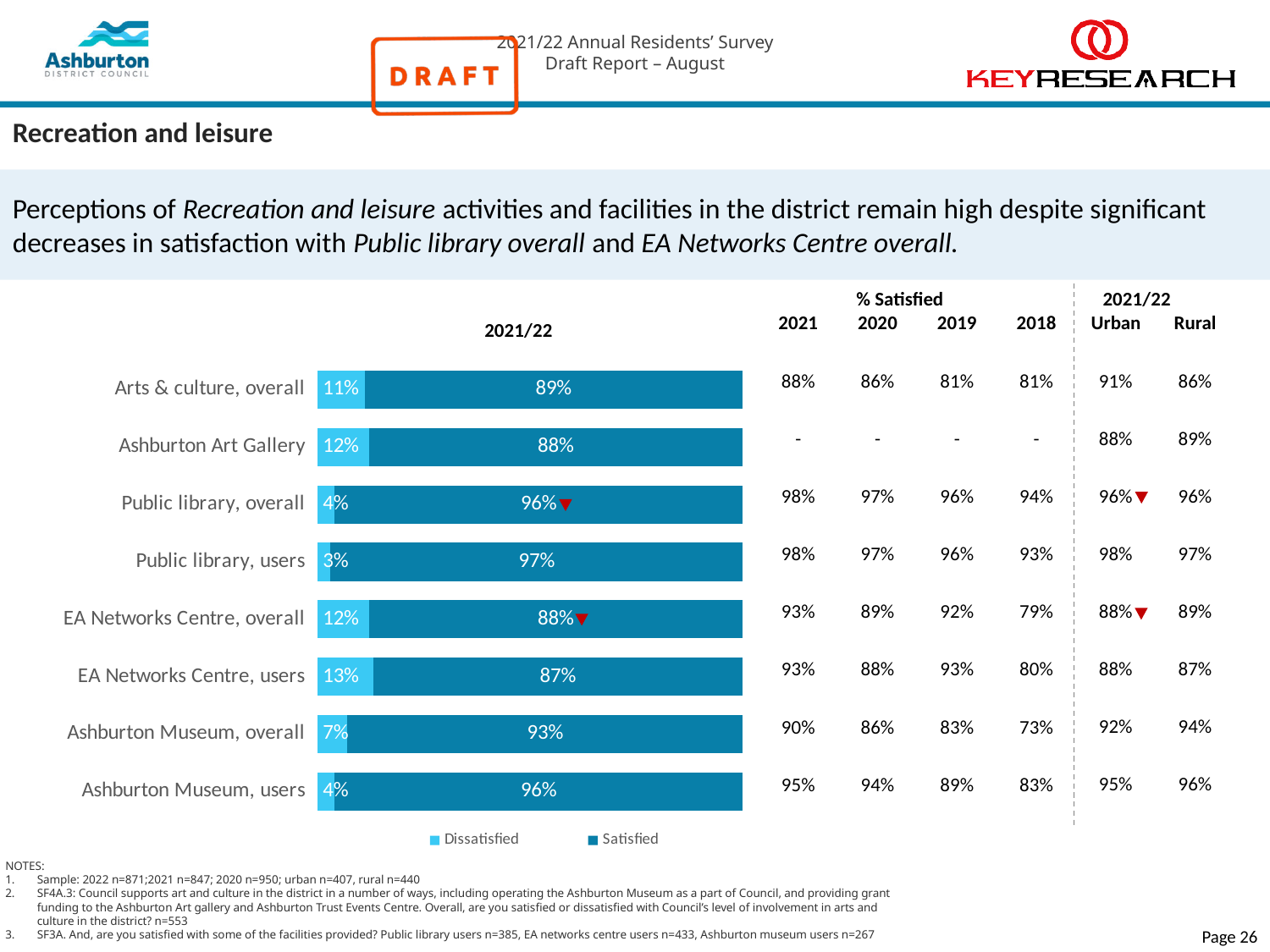
Which category has the highest satisfied percentage in the 2021/22 chart? Public library, users How many series does the chart legend list? 2 Which has a higher satisfied percentage in 2021/22: Arts & culture, overall or Ashburton Museum, users? Ashburton Museum, users Which category has the lowest satisfied percentage in the 2021/22 chart? EA Networks Centre, users What is the satisfied percentage for Ashburton Museum, overall in the 2021/22 chart? 93% What percentage of respondents were satisfied with Public library, users in 2021/22? 97% What is the total of the Dissatisfied and Satisfied segments for Ashburton Art Gallery in 2021/22? 100% What are the two series named in the chart legend? Dissatisfied and Satisfied What type of chart is used to show the 2021/22 satisfaction results? Stacked bar chart What is the difference between the satisfied percentages for Public library, overall and EA Networks Centre, overall in 2021/22? 8% How many categories are shown in the 2021/22 bar chart? 8 What percentage of respondents were dissatisfied with EA Networks Centre, users in 2021/22? 13%